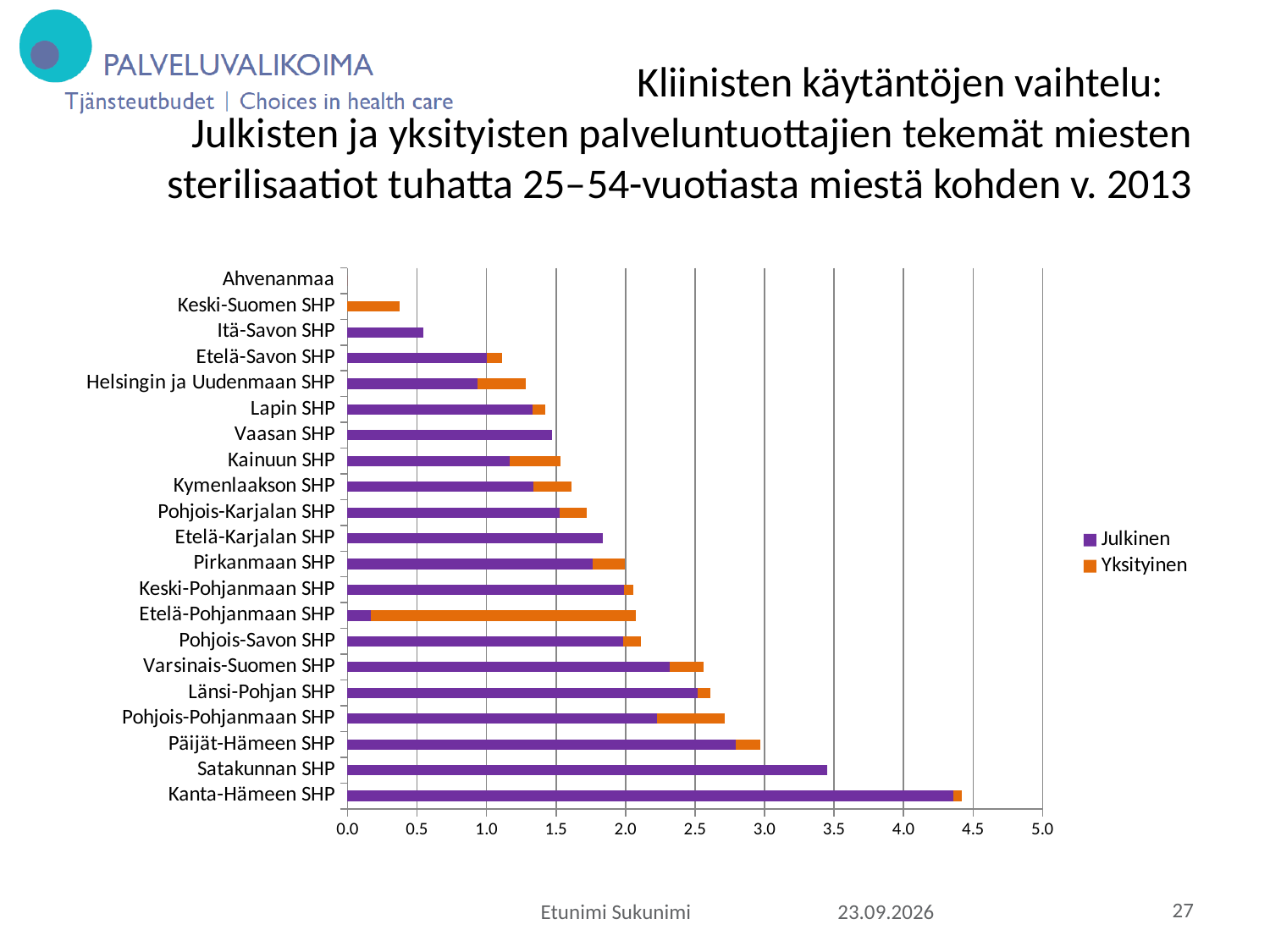
For Etelä-Pohjanmaan SHP, which series has the larger value, Julkinen or Yksityinen? Yksityinen Which category has the highest total value? Kanta-Hämeen SHP Is the total value for Kanta-Hämeen SHP greater or less than 4.0? greater Which has the larger total value, Satakunnan SHP or Päijät-Hämeen SHP? Satakunnan SHP What are the two series named in the legend? Julkinen and Yksityinen Which category has the lowest total value? Ahvenanmaa How many hospital districts (categories) are shown on the chart? 21 Is the total value for Satakunnan SHP greater or less than 3.0? greater Which category has the largest Yksityinen segment? Etelä-Pohjanmaan SHP Is the total value for Keski-Suomen SHP greater or less than 0.5? less What kind of chart is shown on the slide? bar chart How many series does the legend list? 2